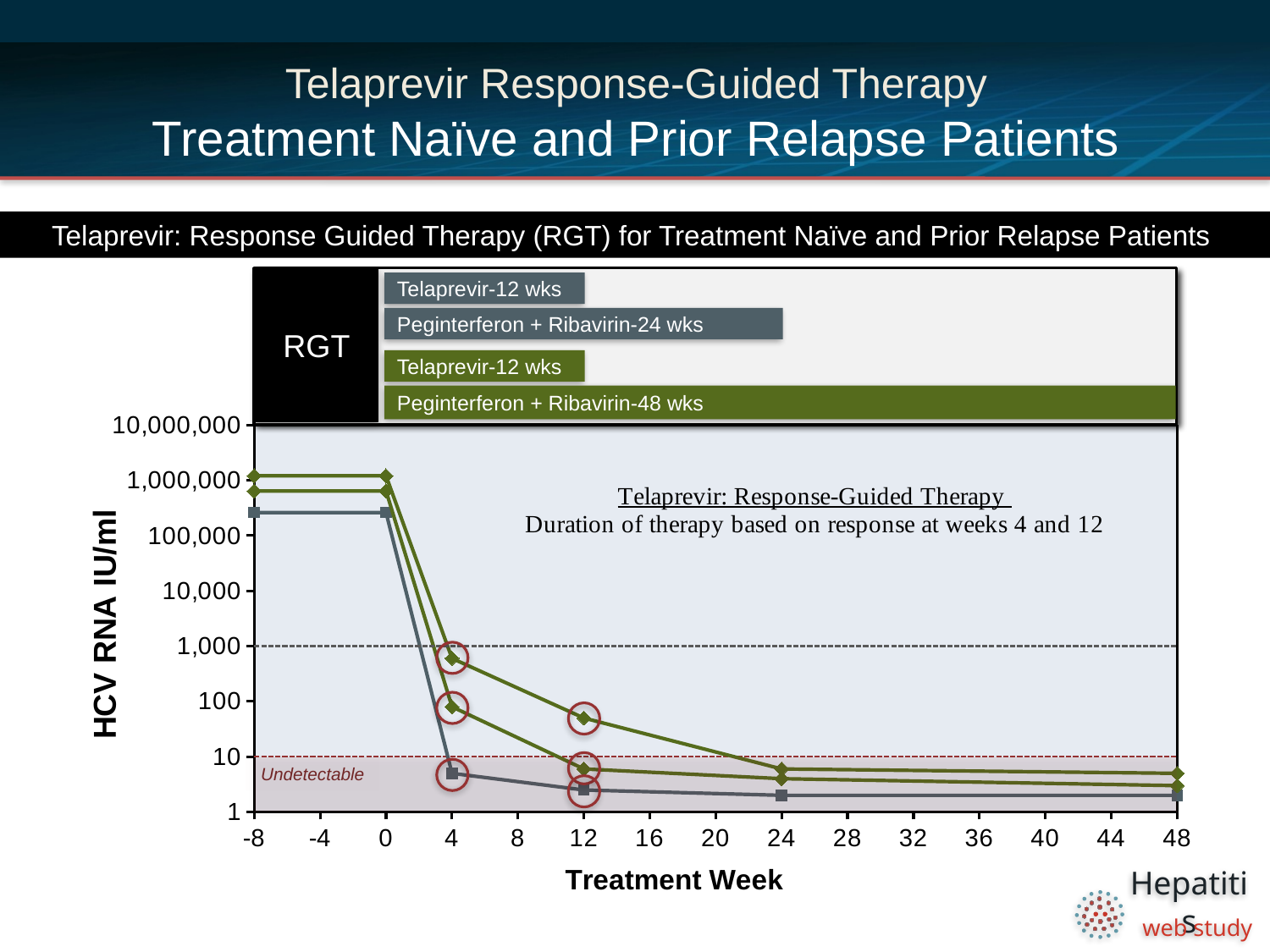
Is the value of the gray line at treatment week 0 greater or less than 100,000? greater What is the label of the y axis of the chart? HCV RNA IU/ml What is the highest tick value shown on the y axis? 10,000,000 What kind of chart is shown on the slide? line chart What is the label of the x axis of the chart? Treatment Week Do the plotted HCV RNA values rise or fall along the x axis after week 0? fall Is the value of the gray line at treatment week 4 greater or less than 10? less Is the value of the upper green line at treatment week 12 greater or less than 10? greater How many tick labels are shown on the x axis? 15 How many lines are plotted on the chart? 3